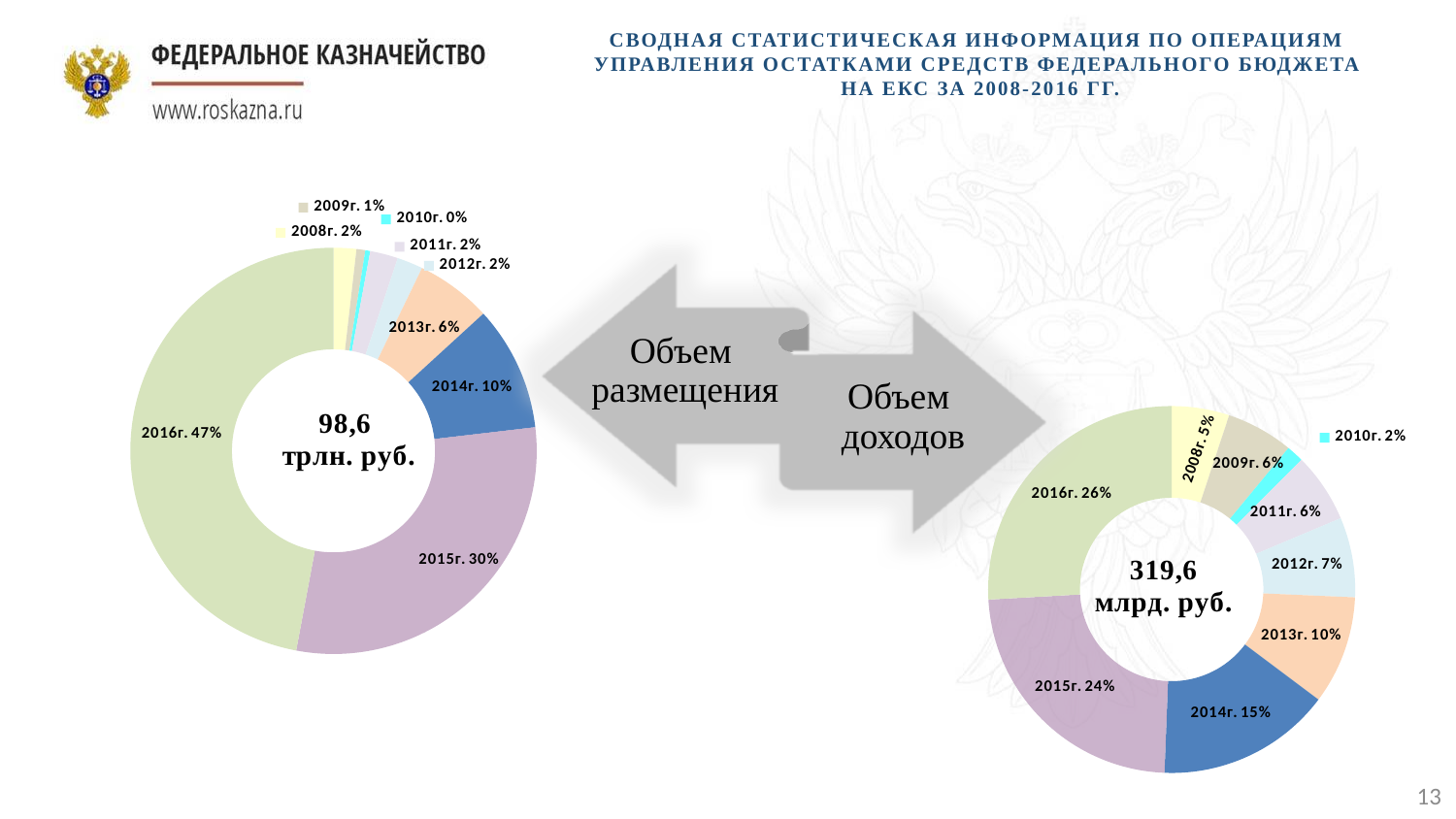
In the right chart (Объем доходов), what share does 2014г. have? 15% In the right chart (Объем доходов), which year has the smallest share? 2010г. In the left chart (Объем размещения), what is the difference between the shares of 2016г. and 2015г.? 17% In the left chart (Объем размещения), what share does 2015г. have? 30% How many year categories are shown in the right chart (Объем доходов)? 9 In the left chart (Объем размещения), what total value is shown in the centre of the donut? 98,6 трлн. руб. In the left chart (Объем размещения), what share does 2016г. have? 47% In the right chart (Объем доходов), which is larger, the share of 2013г. or the share of 2012г.? 2013г. What type of chart is used for Объем размещения on the left? Donut (pie) chart In the left chart (Объем размещения), which year has the largest share? 2016г. In the left chart (Объем размещения), which year has the smallest share? 2010г. In the right chart (Объем доходов), what share does 2012г. have? 7%